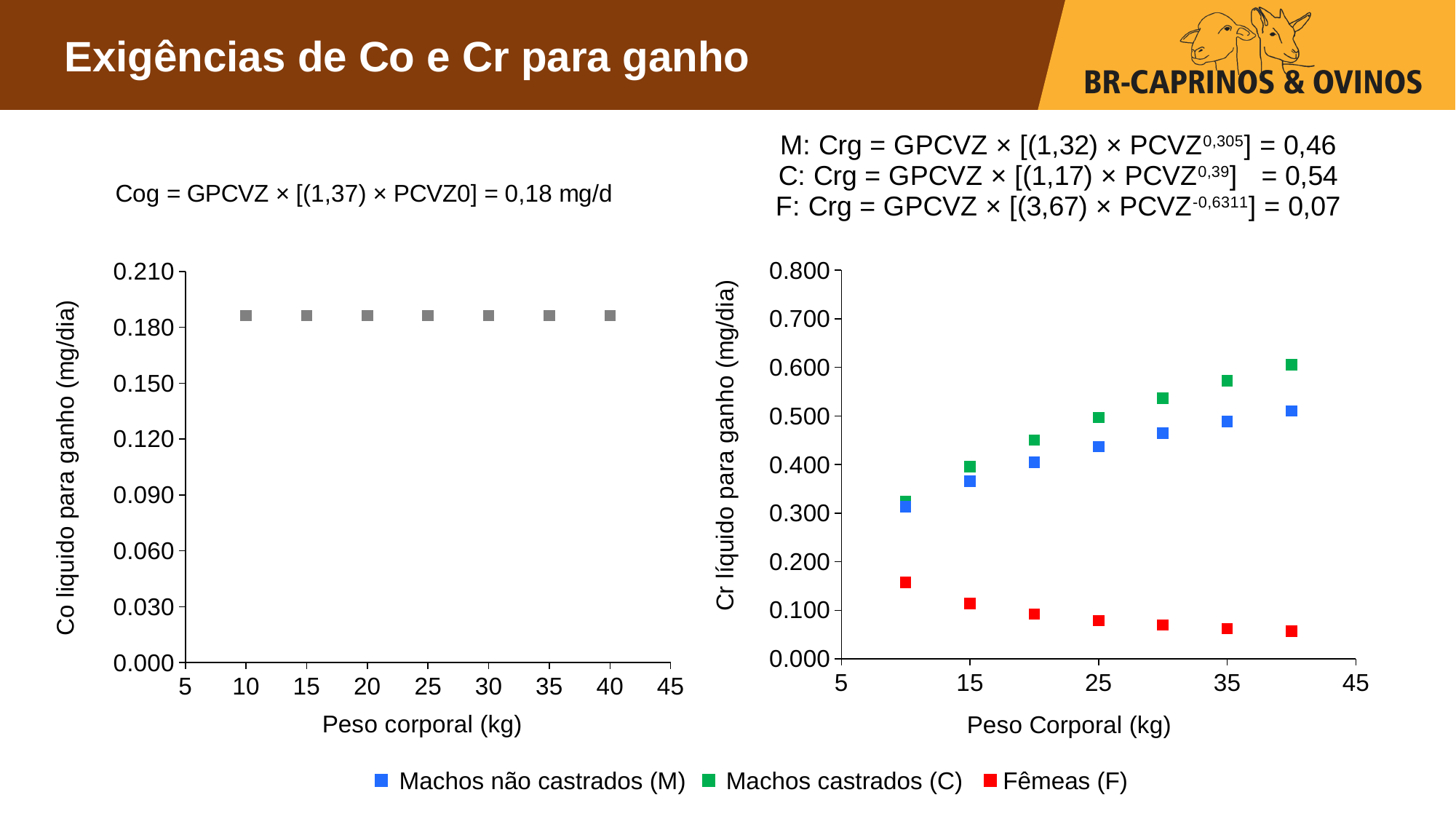
In the right chart, what colour are the markers for Fêmeas (F)? red What kind of chart is the left chart (Co liquido para ganho)? scatter chart In the right chart (Cr líquido para ganho), do the values for Fêmeas (F) rise or fall as body weight increases? fall In the right chart (Cr líquido para ganho), is the value for Machos castrados (C) at 40 kg greater or less than 0.500? greater In the left chart (Co liquido para ganho), is the value at 20 kg greater or less than 0.150? greater What kind of chart is the right chart (Cr líquido para ganho)? scatter chart In the right chart (Cr líquido para ganho), at 40 kg, which series has the larger value: Machos castrados (C) or Machos não castrados (M)? Machos castrados (C) In the right chart (Cr líquido para ganho), is the value for Fêmeas (F) at 10 kg greater or less than 0.200? less How many series does the legend of the right chart (Cr líquido para ganho) list? 3 In the left chart (Co liquido para ganho), do the values rise, fall or stay flat as body weight increases? stay flat In the left chart (Co liquido para ganho), how many data points are plotted? 7 In the right chart (Cr líquido para ganho), do the values for Machos castrados (C) rise or fall as body weight increases? rise